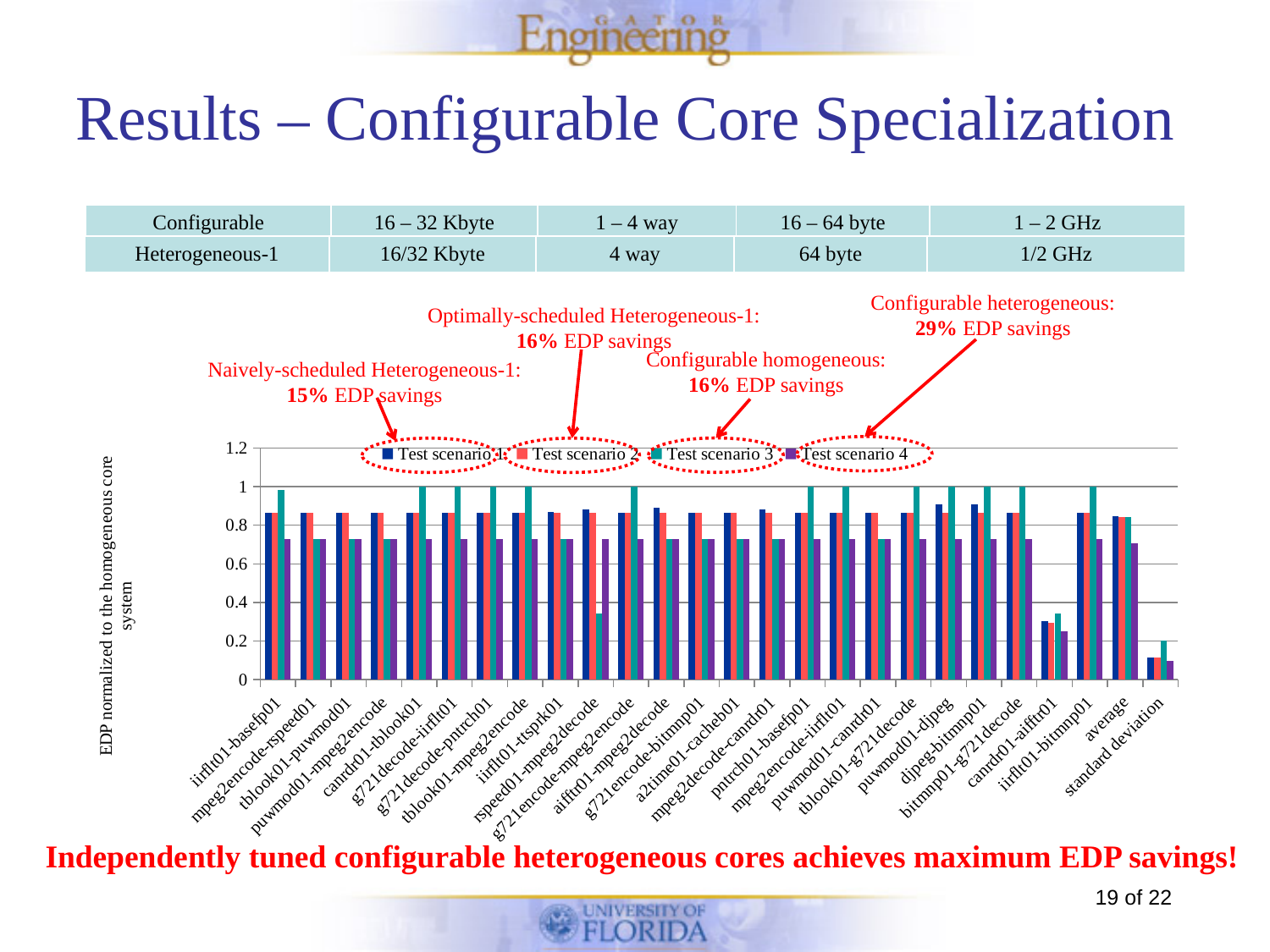
How many series does the chart's legend list? 4 Is the Test scenario 4 value for canrdr01-aifftr01 greater or less than 0.4? less For iirflt01-basefp01, which is larger: the Test scenario 3 value or the Test scenario 4 value? Test scenario 3 Is the Test scenario 1 value for standard deviation greater or less than 0.4? less For canrdr01-aifftr01, which is larger: the Test scenario 3 value or the Test scenario 4 value? Test scenario 3 What are the four legend entries of the chart? Test scenario 1, Test scenario 2, Test scenario 3, Test scenario 4 Is the Test scenario 2 value for rspeed01-mpeg2decode greater or less than 0.6? greater How many categories are shown along the x axis of the chart? 26 What kind of chart is shown on the slide? bar chart What is the title of the chart's vertical axis? EDP normalized to the homogeneous core system Which category has the lowest Test scenario 1 value? standard deviation